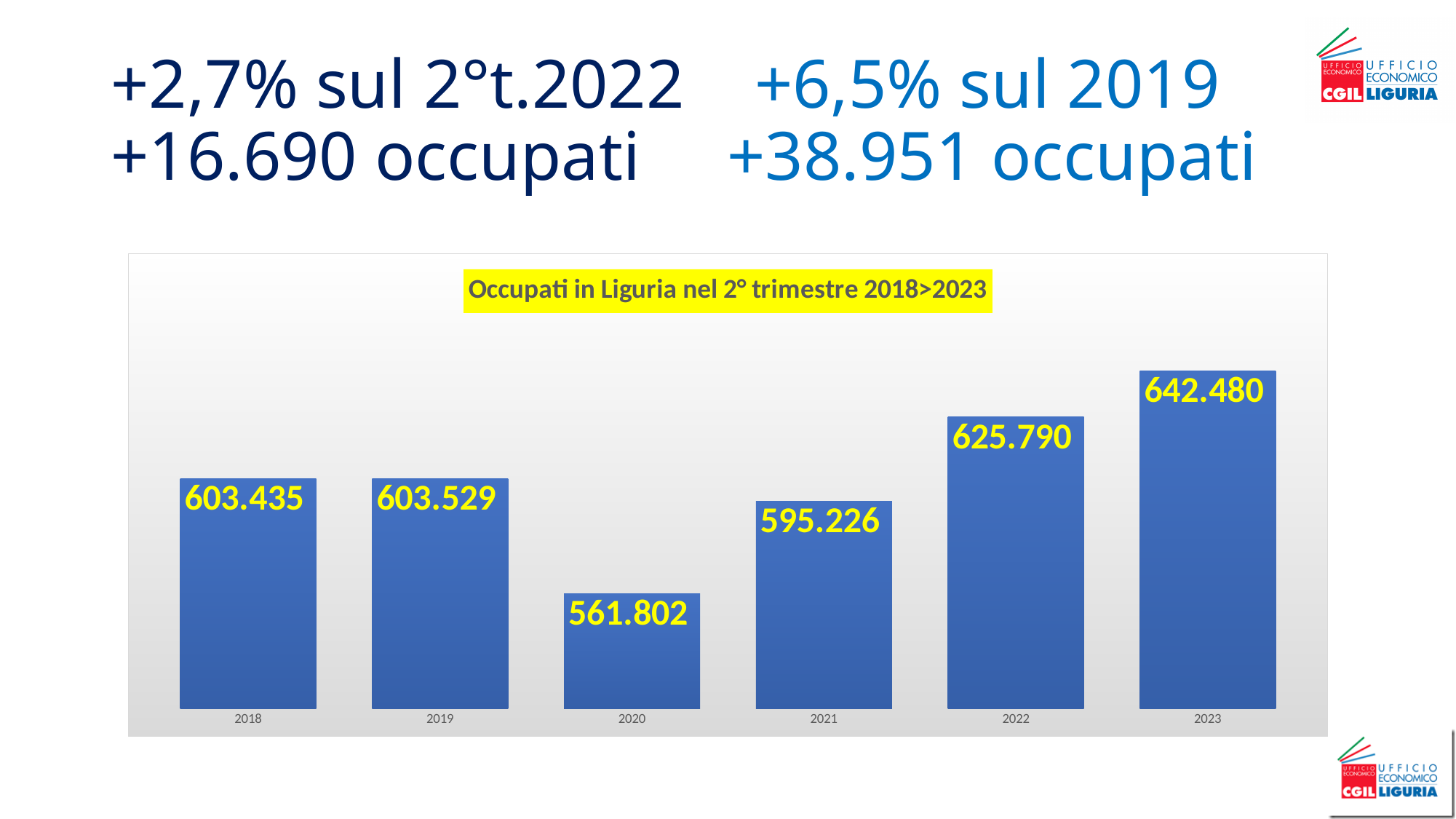
What is the value for 2021? 595.226 What is the title of the chart? Occupati in Liguria nel 2° trimestre 2018>2023 What is the value for 2020? 561.802 What kind of chart is shown on the slide? bar chart Which year has the lowest value? 2020 Do the values rise or fall from 2020 to 2023? rise What is the difference between the values for 2023 and 2022? 16.690 What is the difference between the values for 2023 and 2019? 38.951 Which year has the highest value? 2023 What is the value for 2023? 642.480 How many years (bars) are shown in the chart? 6 Which is larger, the value for 2021 or the value for 2022? 2022